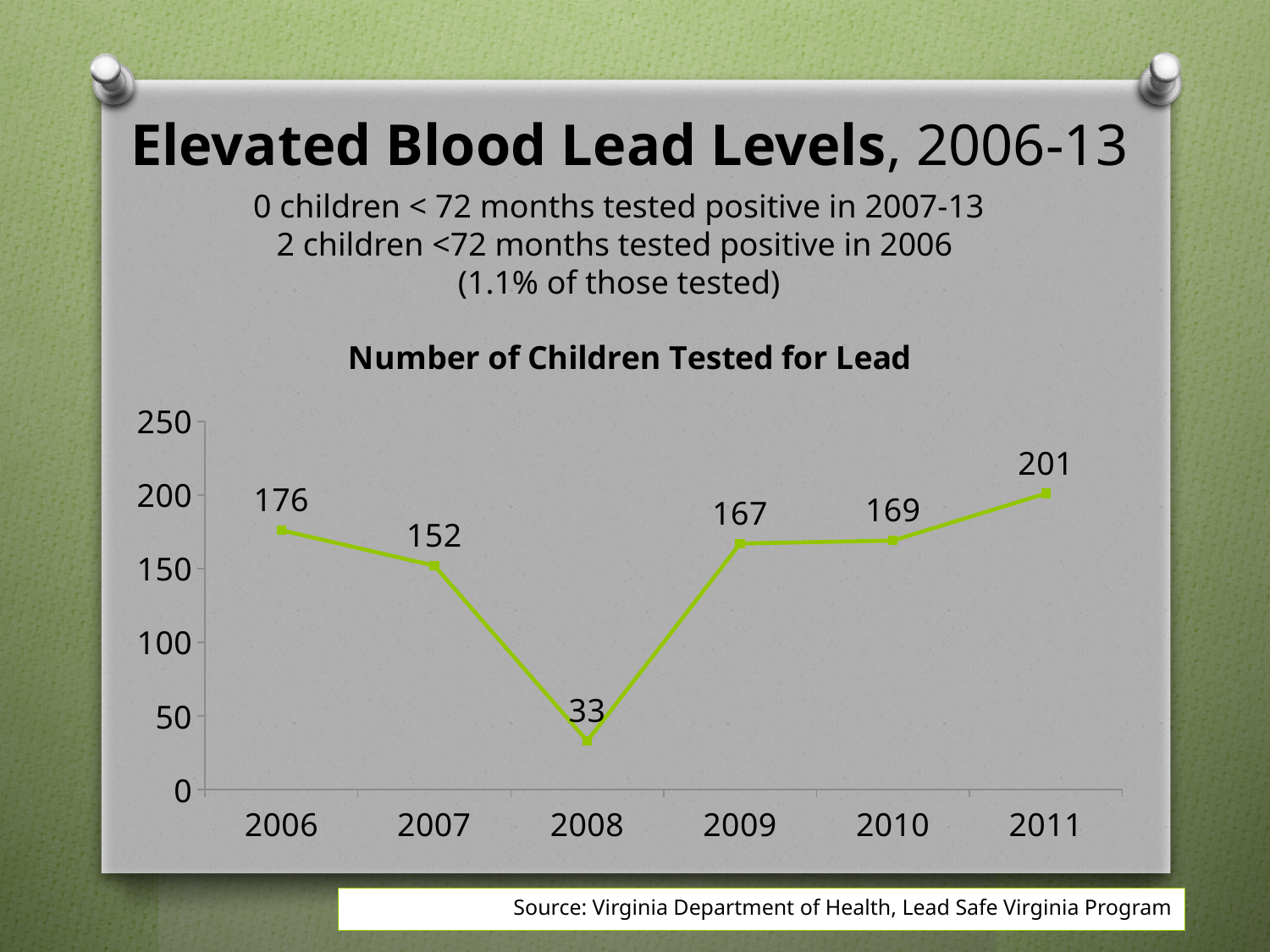
Which year had more children tested for lead, 2009 or 2010? 2010 Which year has the lowest number of children tested for lead? 2008 Which year has the highest number of children tested for lead? 2011 What is the number of children tested for lead in 2006? 176 What is the title of the chart? Number of Children Tested for Lead What is the number of children tested for lead in 2008? 33 What is the difference between the number of children tested in 2011 and in 2008? 168 What is the difference between the number of children tested in 2006 and in 2007? 24 Is the number of children tested for lead in 2008 greater or less than 50? less How many years are plotted on the chart? 6 What kind of chart is shown on the slide? line chart What is the number of children tested for lead in 2011? 201